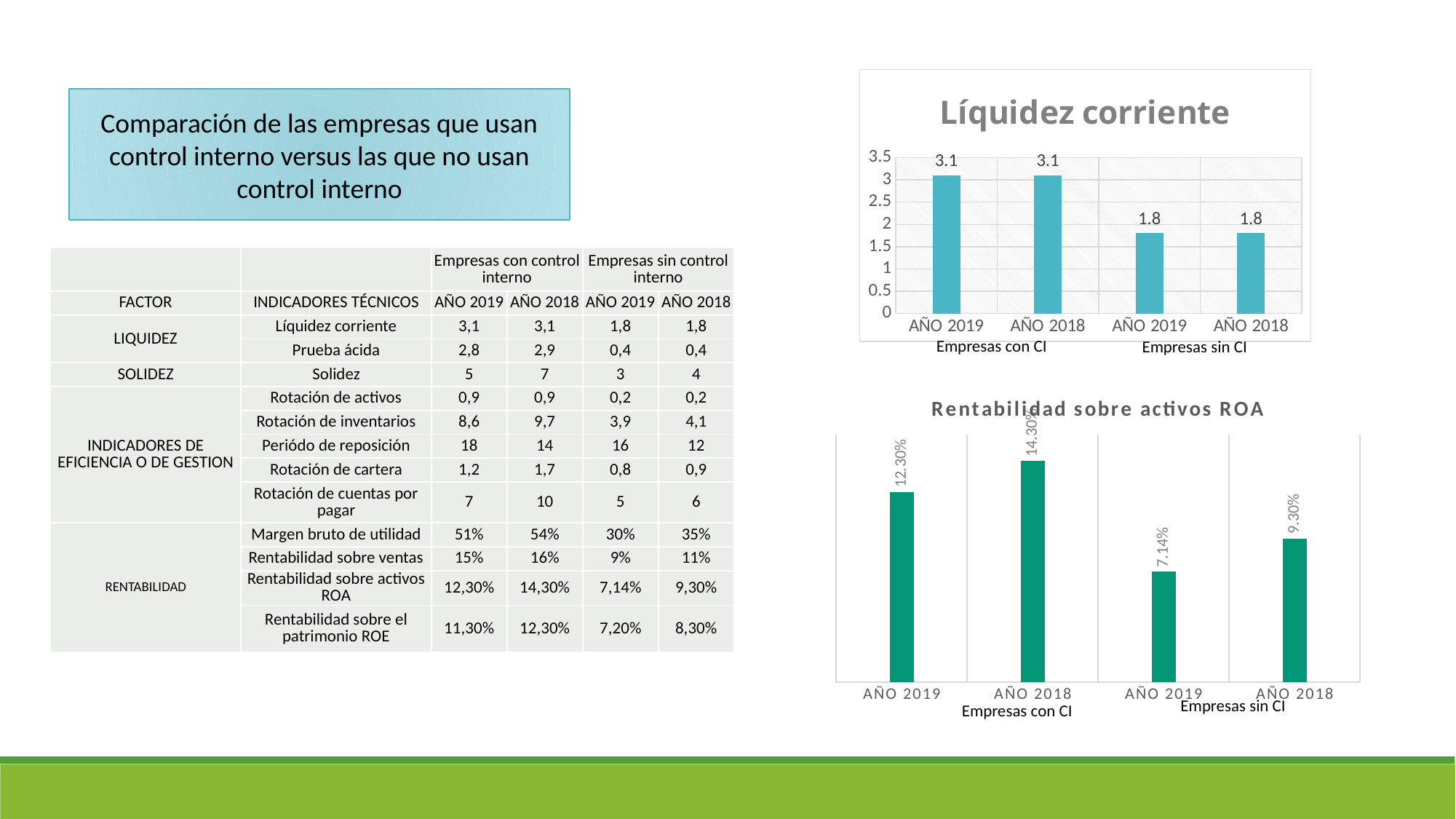
What kind of chart is 'Líquidez corriente'? Bar chart In the 'Líquidez corriente' chart, what is the value for AÑO 2019 under Empresas con CI? 3.1 In the 'Líquidez corriente' chart, what is the difference between the AÑO 2019 value for Empresas con CI and the AÑO 2019 value for Empresas sin CI? 1.3 In the 'Rentabilidad sobre activos ROA' chart, which bar has the highest value? AÑO 2018 (Empresas con CI) In the 'Rentabilidad sobre activos ROA' chart, which is larger: the AÑO 2019 value for Empresas con CI or the AÑO 2018 value for Empresas sin CI? AÑO 2019 for Empresas con CI In the 'Rentabilidad sobre activos ROA' chart, what is the difference between the AÑO 2018 value for Empresas con CI and the AÑO 2018 value for Empresas sin CI? 5.00% In the 'Rentabilidad sobre activos ROA' chart, which bar has the lowest value? AÑO 2019 (Empresas sin CI) In the 'Líquidez corriente' chart, is the value for AÑO 2018 under Empresas sin CI greater or less than 2? less In the 'Líquidez corriente' chart, how many bars are plotted? 4 In the 'Rentabilidad sobre activos ROA' chart, what is the value for AÑO 2018 under Empresas con CI? 14.30% In the 'Rentabilidad sobre activos ROA' chart, what is the value for AÑO 2019 under Empresas sin CI? 7.14% In the 'Líquidez corriente' chart, what is the value for AÑO 2018 under Empresas sin CI? 1.8